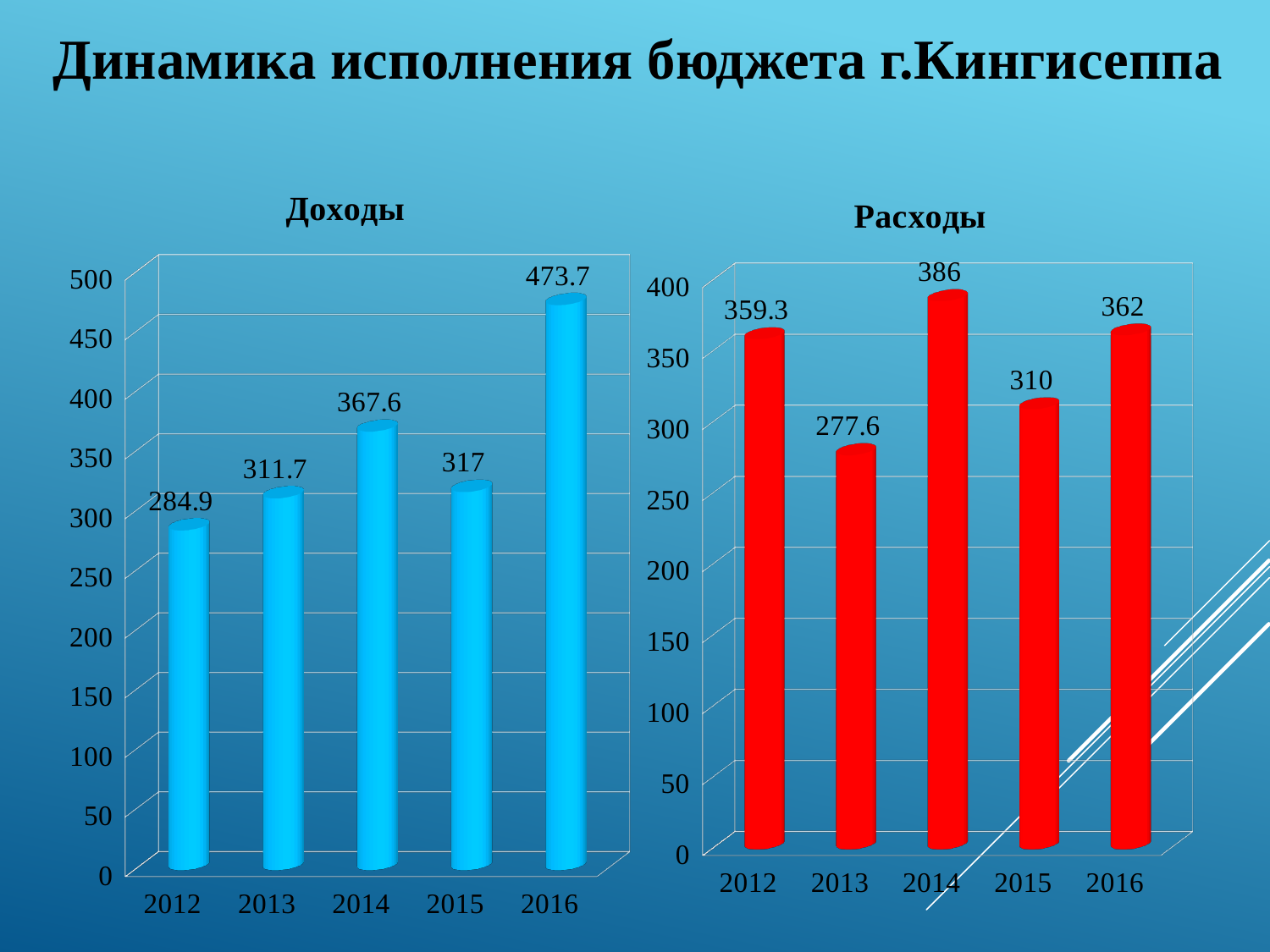
In the Доходы chart, which year has the lowest value? 2012 What kind of chart is the Доходы chart? bar chart In the Доходы chart, is the value for 2014 greater or less than 350? greater In the Расходы chart, what is the difference between the values for 2014 and 2013? 108.4 In the Расходы chart, which year has the highest value? 2014 What colour are the bars in the Расходы chart? red In the Расходы chart, which is larger, the value for 2012 or the value for 2015? 2012 In the Расходы chart, what is the value for 2013? 277.6 In the Доходы chart, what is the value for 2013? 311.7 In the Доходы chart, what is the difference between the values for 2016 and 2015? 156.7 In the Доходы chart, what is the value for 2016? 473.7 How many years are shown in the Расходы chart? 5